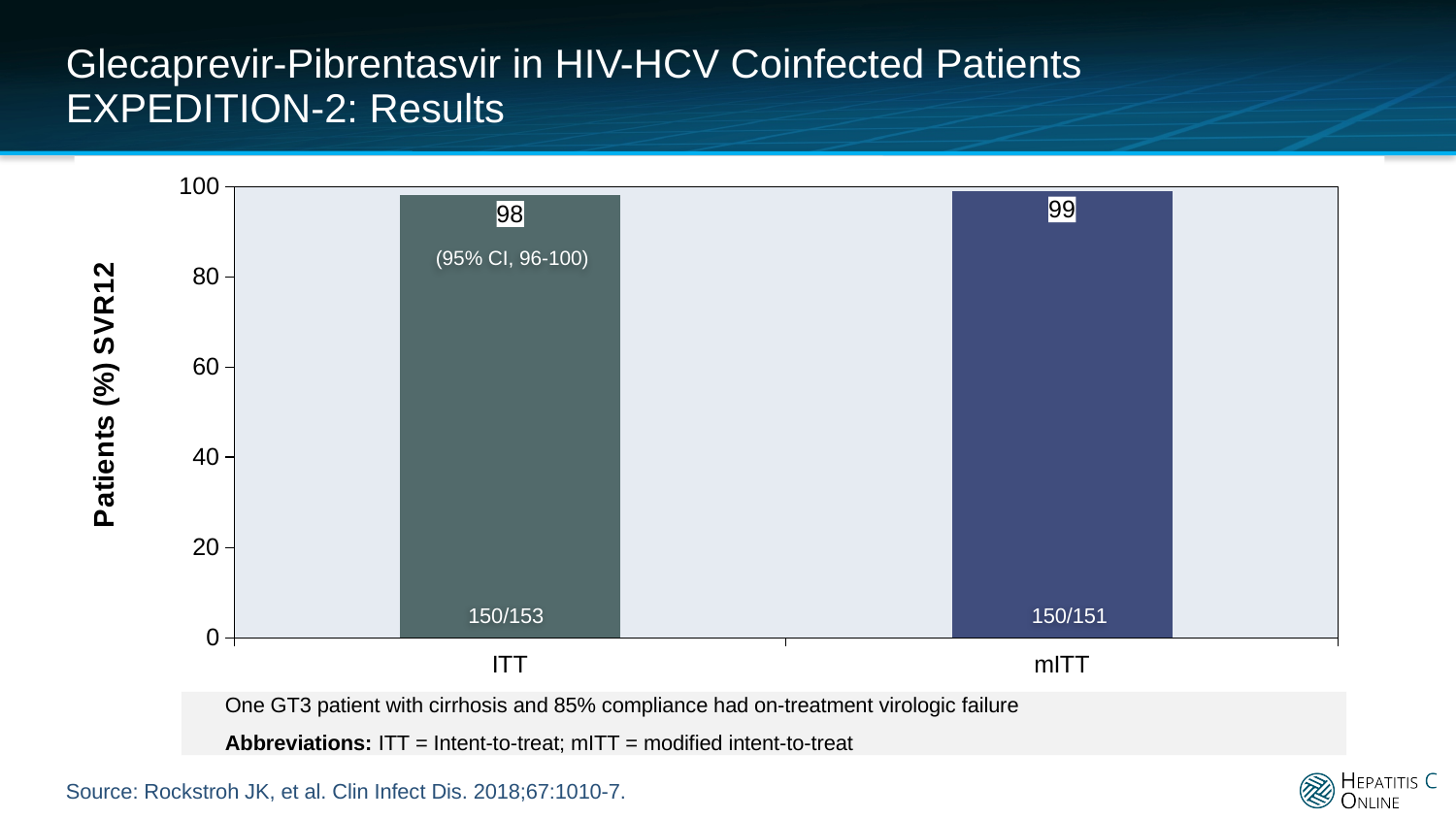
What does the abbreviation mITT stand for, according to the slide? Modified intent-to-treat What is the 95% confidence interval shown for the ITT group? 96-100 What is the SVR12 rate (%) for the mITT group? 99 Which group has the higher SVR12 rate, ITT or mITT? mITT What kind of chart is shown on the slide? Bar chart How many patients achieved SVR12 out of the total in the mITT group, as shown on the bar? 150/151 How many categories are plotted on the chart? 2 Is the value for ITT greater or less than 80? greater What is the difference in SVR12 rate (%) between the mITT and ITT groups? 1 How many patients achieved SVR12 out of the total in the ITT group, as shown on the bar? 150/153 What is the SVR12 rate (%) for the ITT group? 98 What is the label of the y-axis? Patients (%) SVR12